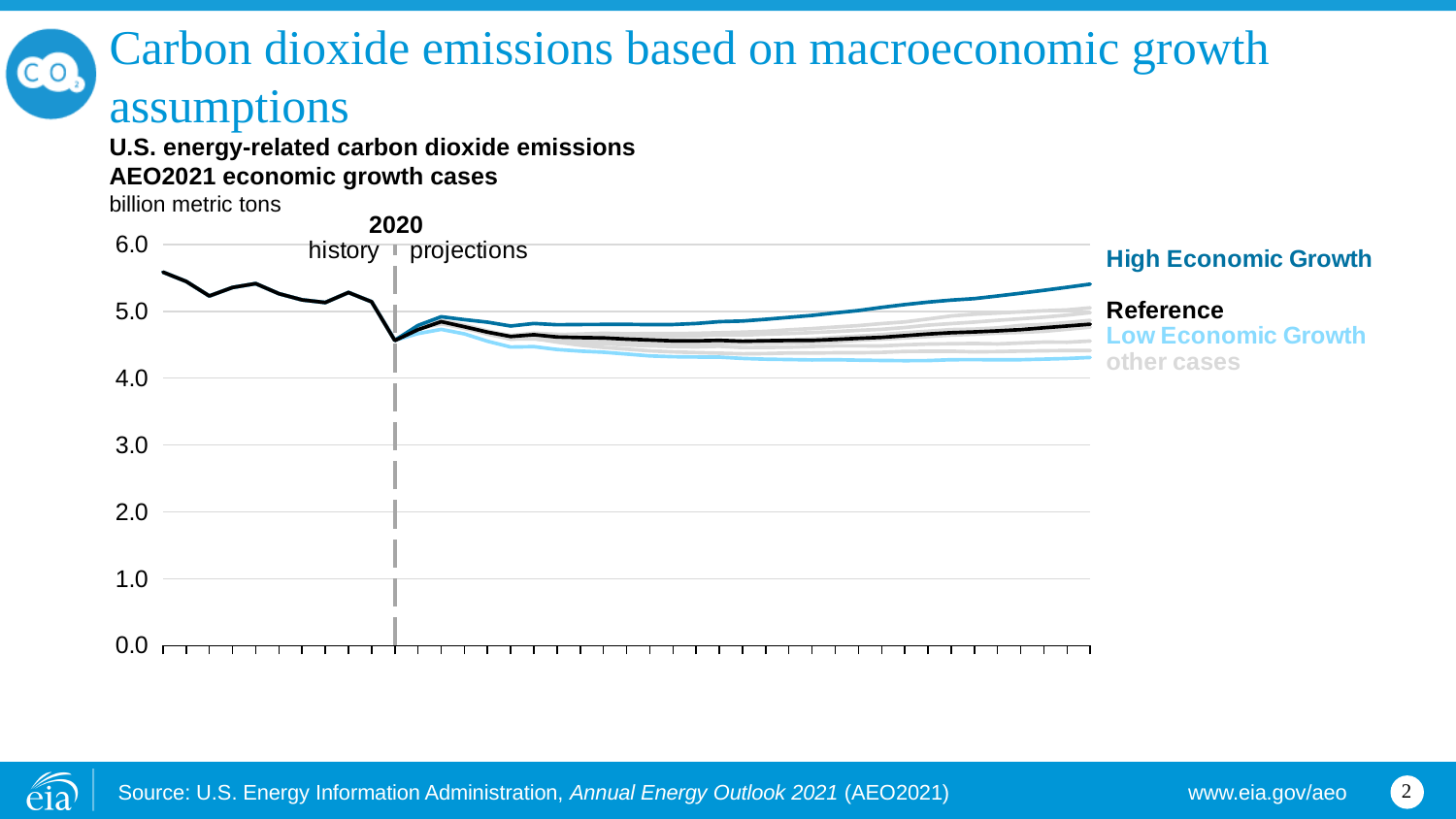
What year does the dashed vertical line separating history from projections mark? 2020 Does the High Economic Growth line rise or fall over the projection period after its initial dip? rise What kind of chart is shown on the slide? line chart Do emissions rise or fall overall across the history period shown? fall Is the value of the Low Economic Growth line at the end of the projection period greater or less than 4.0? greater Is the value of the Reference line at the end of the projection period greater or less than 5.0? less Which case has the highest emissions at the end of the projection period? High Economic Growth Is the value of the High Economic Growth line at the end of the projection period greater or less than 5.0? greater What unit is used on the y axis of the chart? billion metric tons At the end of the projection period, which line is higher: High Economic Growth or Low Economic Growth? High Economic Growth At the end of the projection period, which line is higher: Reference or Low Economic Growth? Reference